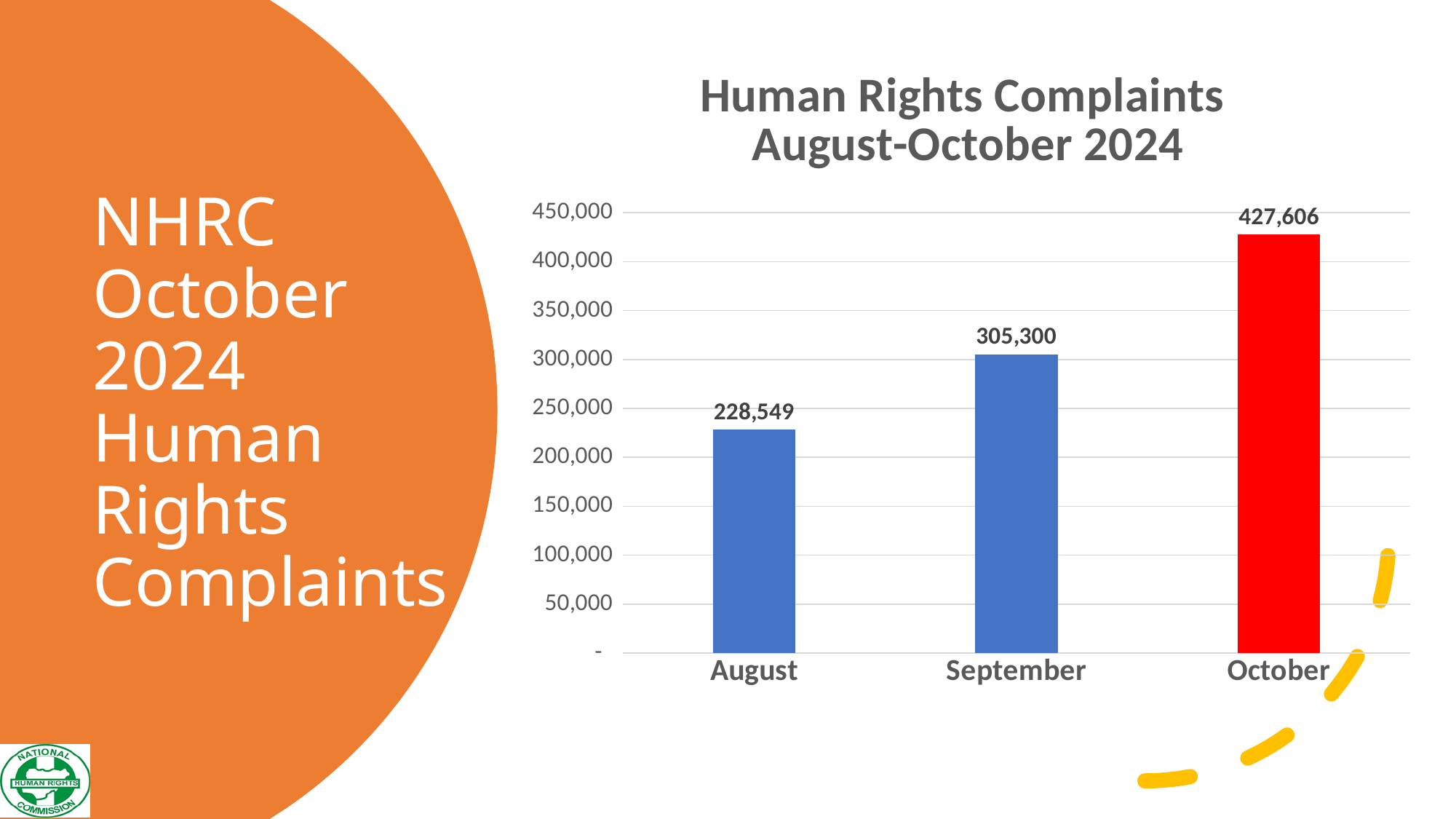
How many months are shown on the chart? 3 Which is larger, the value for August or the value for September? September What is the value for September? 305,300 Is the value for October greater or less than 400,000? greater Which month has the highest number of complaints? October What is the difference between the September and August values? 76,751 Which month has the lowest number of complaints? August What is the difference between the October and September values? 122,306 Do the values rise or fall from August to October? rise What is the value for August? 228,549 What kind of chart is shown on the slide? bar chart What is the value for October? 427,606